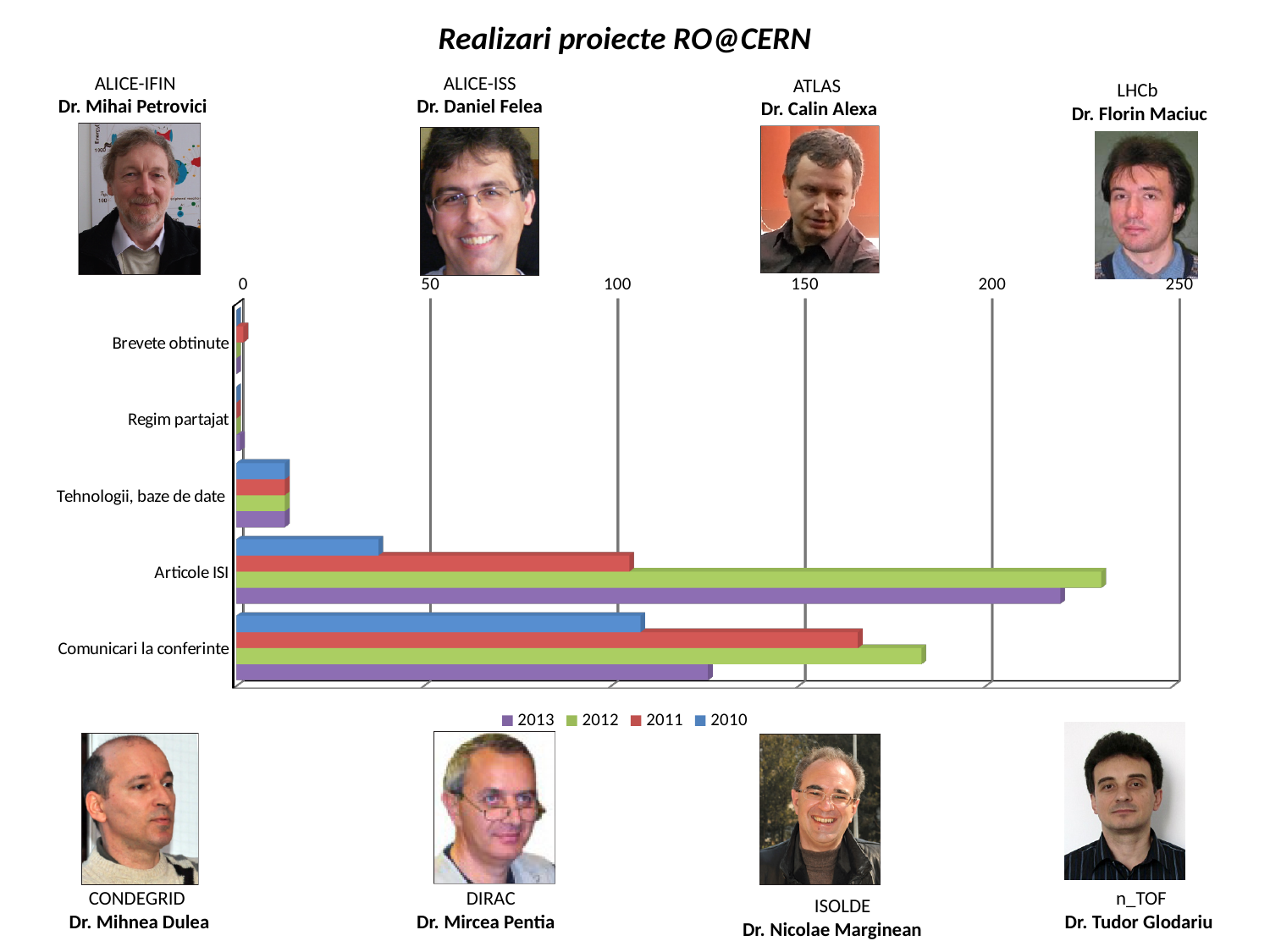
Which is larger: the 2011 value for Articole ISI or the 2011 value for Comunicari la conferinte? Comunicari la conferinte Which is larger: the 2012 value for Articole ISI or the 2012 value for Comunicari la conferinte? Articole ISI How many categories are shown on the chart's vertical axis? 5 Is the 2010 value for Articole ISI greater or less than 50? less Is the 2012 value for Articole ISI greater or less than 200? greater How many series does the chart legend list? 4 Is the 2011 value for Comunicari la conferinte greater or less than 150? greater Which years are listed in the chart legend? 2013, 2012, 2011, 2010 For Articole ISI, which year has the highest value? 2012 What kind of chart is shown on the slide? bar chart